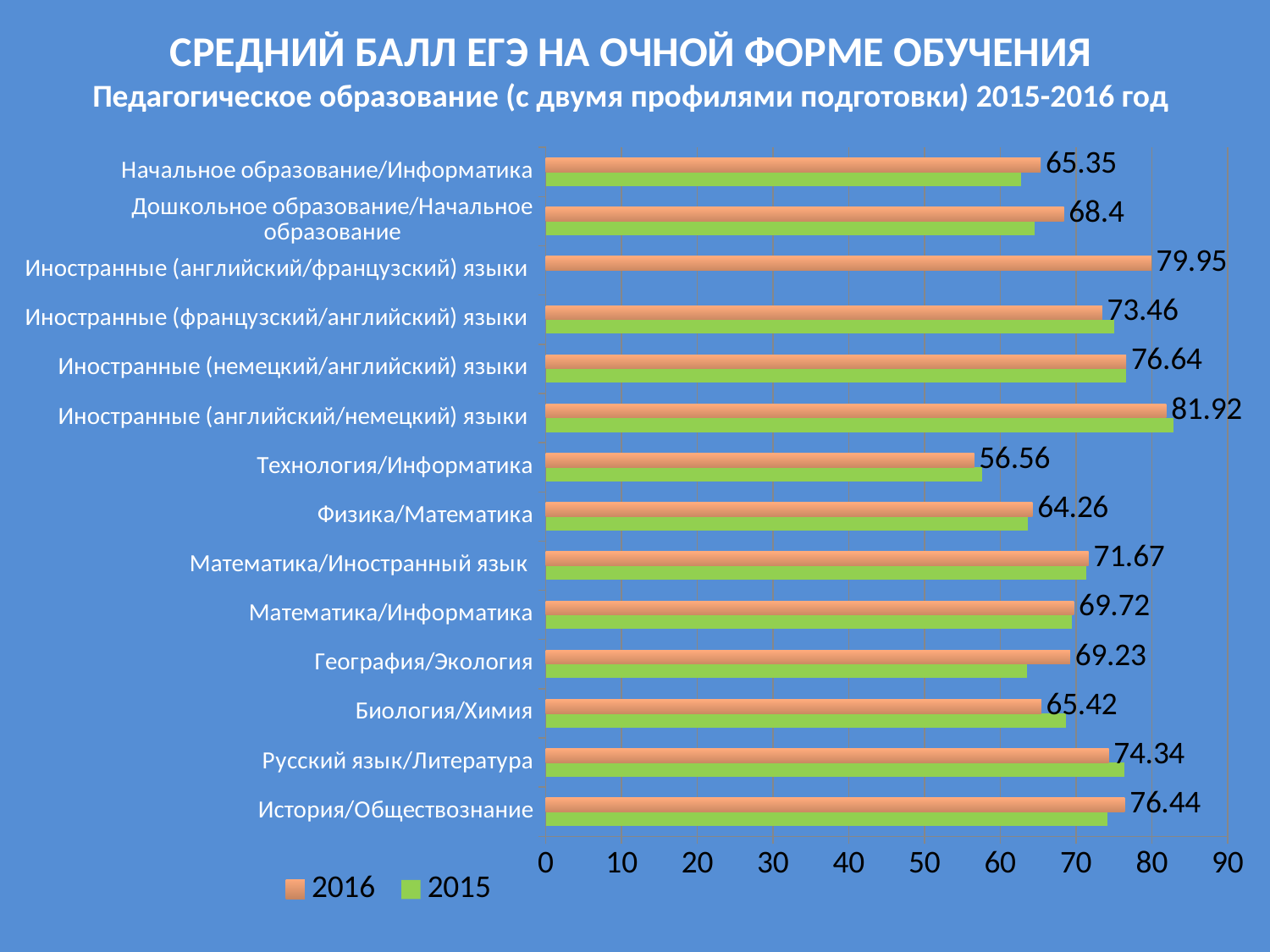
What is the 2016 value for Технология/Информатика? 56.56 What is the 2016 value for Иностранные (английский/французский) языки? 79.95 How many series does the legend list? 2 What is the difference between the 2016 values for Иностранные (английский/немецкий) языки and Технология/Информатика? 25.36 How many categories are shown on the chart? 14 Which category has the lowest 2016 value? Технология/Информатика Which has the larger 2016 value: Русский язык/Литература or История/Обществознание? История/Обществознание What is the 2016 value for История/Обществознание? 76.44 Which category has the highest 2016 value? Иностранные (английский/немецкий) языки What kind of chart is shown on the slide? bar chart Is the 2015 value for Иностранные (английский/немецкий) языки greater or less than 80? greater Is the 2015 value for География/Экология greater or less than 70? less